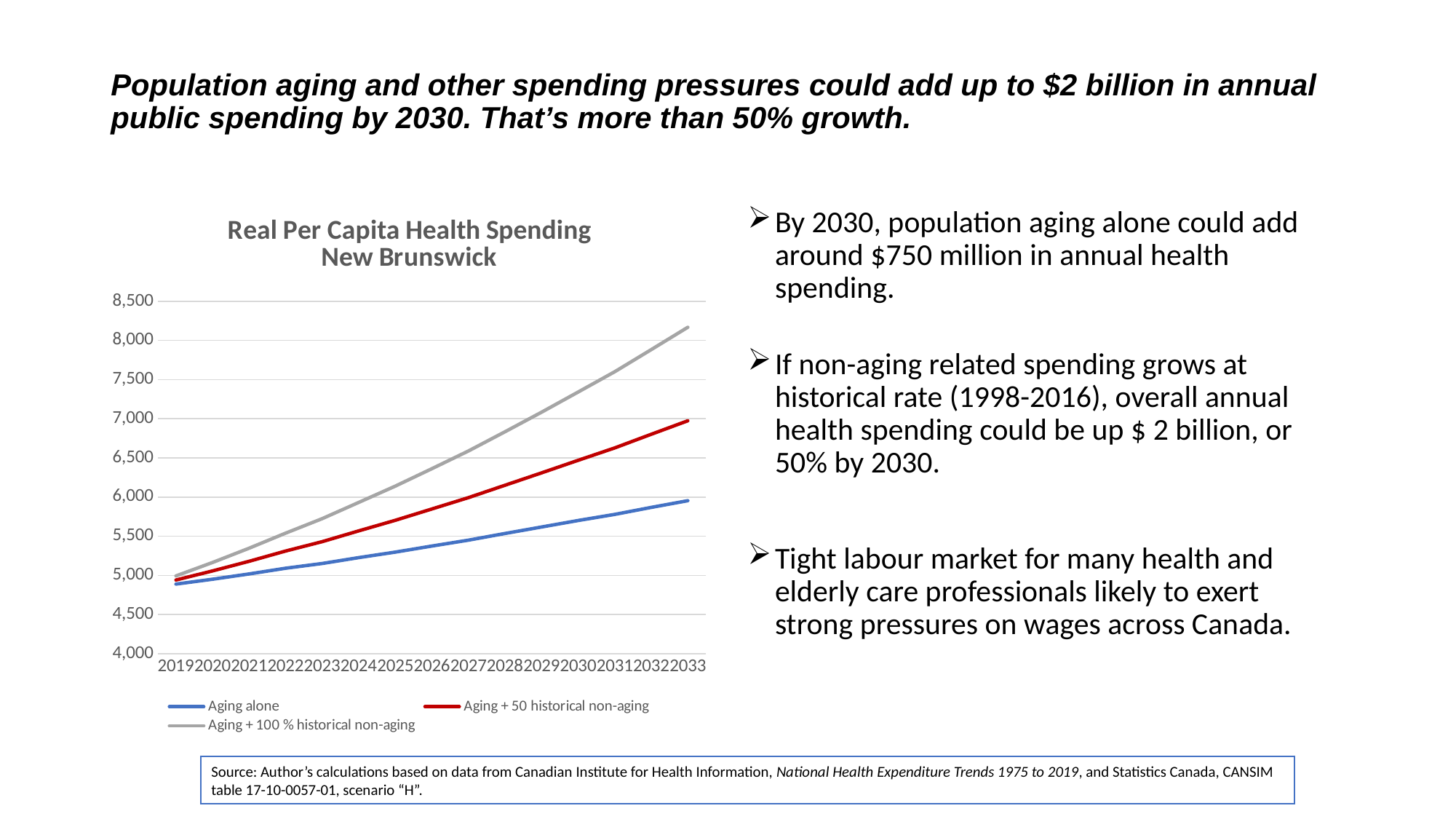
Do the values of the 'Aging alone' series rise or fall from 2019 to 2033? Rise What kind of chart is shown on the slide? Line chart Is the value for 'Aging + 50 historical non-aging' in 2033 greater or less than 6,500? greater Which series has the highest value in 2033? Aging + 100 % historical non-aging Which series in the chart is drawn in red? Aging + 50 historical non-aging In 2033, which is larger: the value for 'Aging alone' or the value for 'Aging + 100 % historical non-aging'? Aging + 100 % historical non-aging Which series has the lowest value in 2033? Aging alone How many years are plotted along the x axis of the chart? 15 How many series does the legend of the chart list? 3 What is the title of the chart? Real Per Capita Health Spending New Brunswick Is the value for 'Aging + 100 % historical non-aging' in 2033 greater or less than 8,000? greater Is the value for 'Aging alone' in 2033 greater or less than 5,500? greater